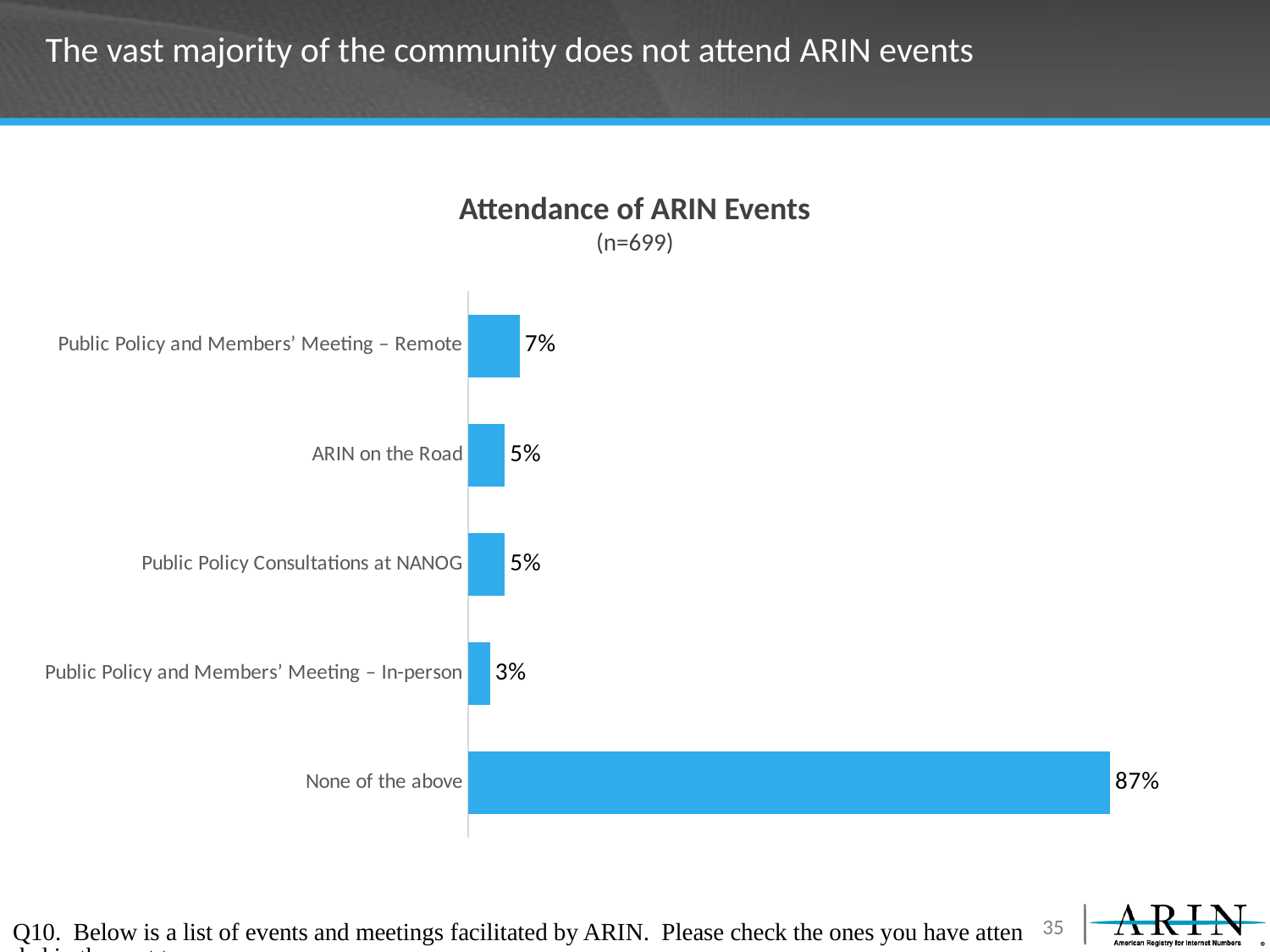
What is the title of the chart? Attendance of ARIN Events Which category has the lowest value? Public Policy and Members' Meeting – In-person What percentage of respondents selected "None of the above"? 87% What kind of chart is shown on the slide? Bar chart Which category has the highest value? None of the above What is the value for "ARIN on the Road"? 5% What is the difference between "Public Policy and Members' Meeting – Remote" and "Public Policy and Members' Meeting – In-person"? 4% What is the difference between "None of the above" and "Public Policy and Members' Meeting – Remote"? 80% Which is larger: the value for "Public Policy and Members' Meeting – Remote" or for "ARIN on the Road"? Public Policy and Members' Meeting – Remote How many categories are shown in the chart? 5 What is the value for "Public Policy and Members' Meeting – Remote"? 7% What is the value for "Public Policy and Members' Meeting – In-person"? 3%